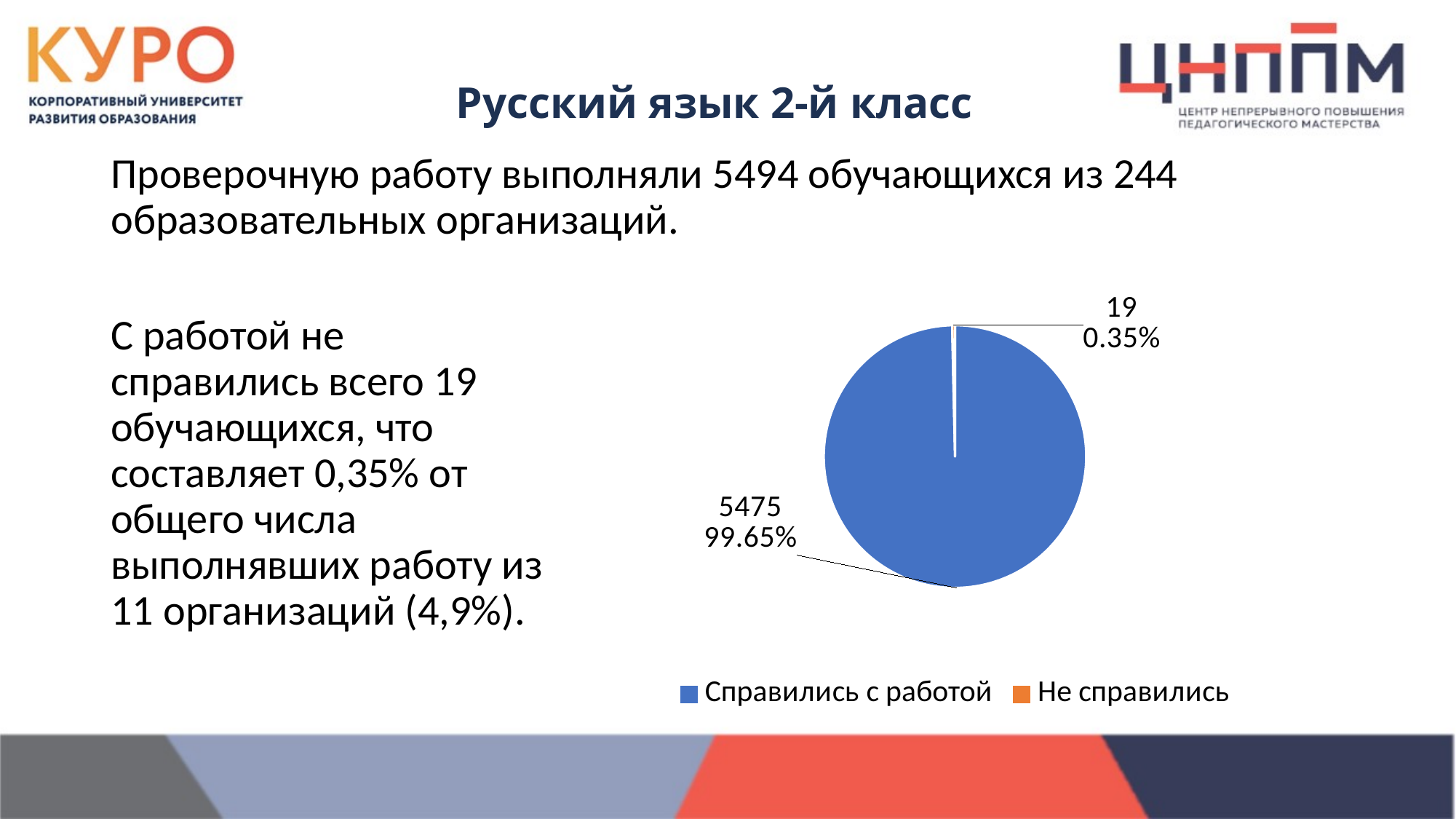
Which slice of the pie chart is the smallest? Не справились What is the value for "Справились с работой" in the pie chart? 5475 What is the difference between the values for "Справились с работой" and "Не справились"? 5456 What is the value for "Не справились" in the pie chart? 19 What share of the pie does "Не справились" take? 0.35% How many slices does the pie chart have? 2 What share of the pie does "Справились с работой" take? 99.65% What colour is the "Справились с работой" slice in the pie chart? blue Which slice of the pie chart is the largest? Справились с работой Which is larger: the value for "Справились с работой" or for "Не справились"? Справились с работой How many entries does the legend of the pie chart list? 2 What kind of chart is shown on the slide? pie chart